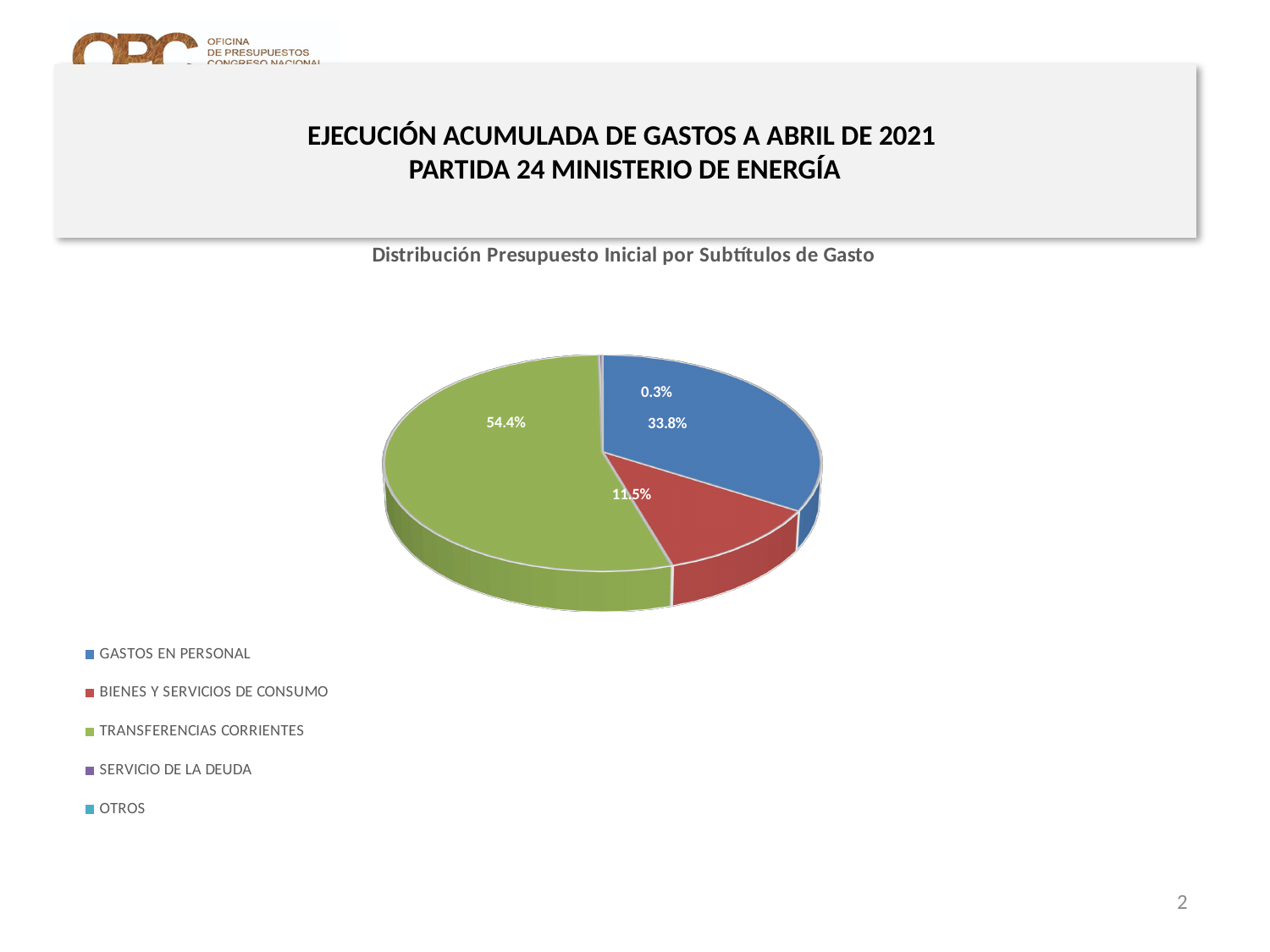
What is the difference between the share for TRANSFERENCIAS CORRIENTES and the share for GASTOS EN PERSONAL? 20.6% Which category has the largest slice of the pie? TRANSFERENCIAS CORRIENTES What kind of chart is shown on the slide? pie chart What share of the pie does SERVICIO DE LA DEUDA represent? 0.3% What is the title of the chart? Distribución Presupuesto Inicial por Subtítulos de Gasto Which of the labelled slices is the smallest? SERVICIO DE LA DEUDA What share of the pie does GASTOS EN PERSONAL represent? 33.8% What share of the pie does TRANSFERENCIAS CORRIENTES represent? 54.4% What colour is the slice for TRANSFERENCIAS CORRIENTES? green How many entries does the chart legend list? 5 Which is larger, the share for GASTOS EN PERSONAL or the share for BIENES Y SERVICIOS DE CONSUMO? GASTOS EN PERSONAL